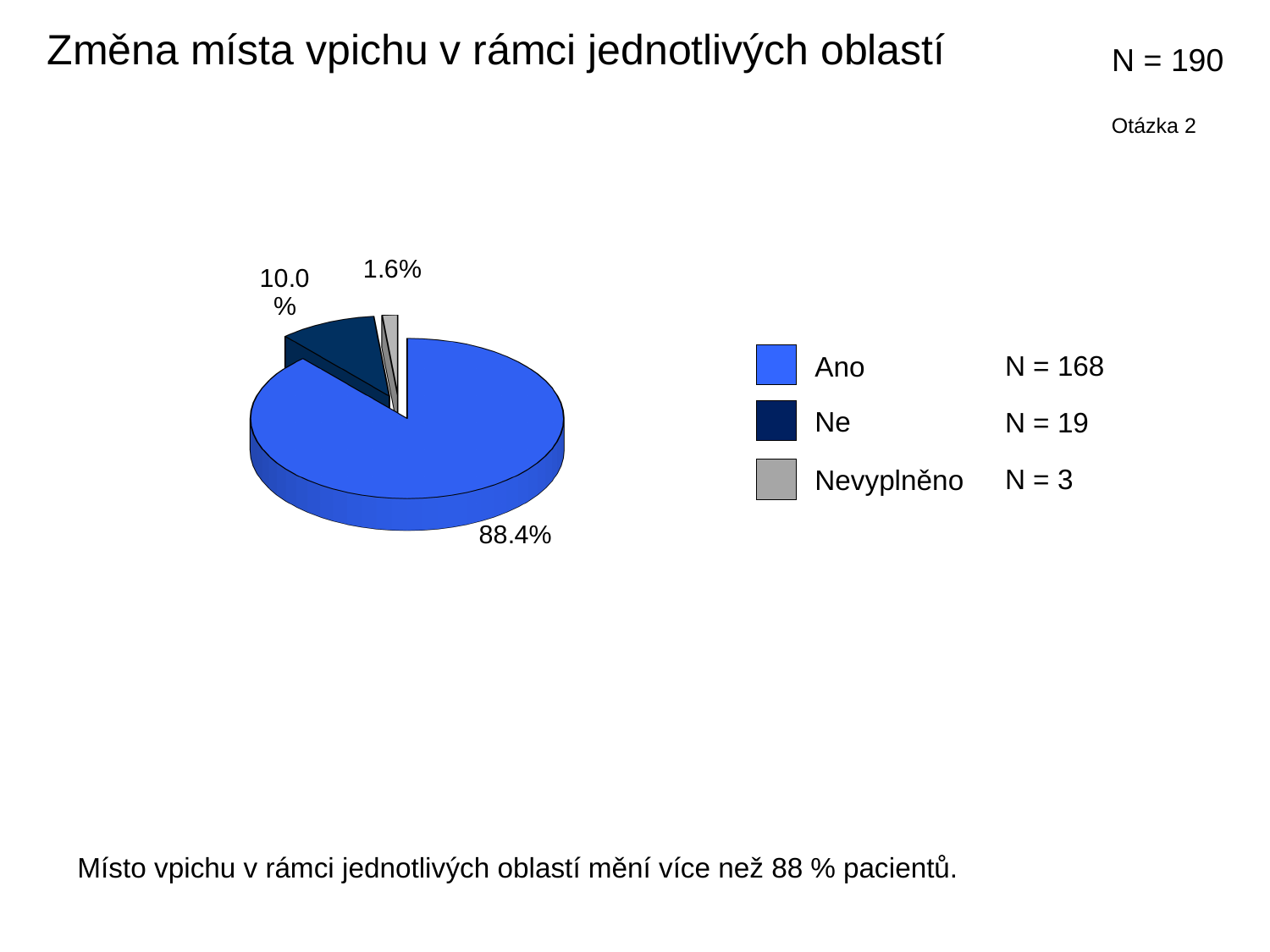
What kind of chart is shown on the slide? pie chart Which category has the smallest slice of the pie? Nevyplněno What is the title of the chart on the slide? Změna místa vpichu v rámci jednotlivých oblastí What percentage share does the "Nevyplněno" slice have? 1.6% What percentage share does the "Ne" slice have? 10.0% Which slice is larger, "Ne" or "Nevyplněno"? Ne What percentage share does the "Ano" slice have? 88.4% What is the difference in percentage points between the "Ano" and "Ne" slices? 78.4 What is the N value shown for "Ne" in the legend? N = 19 What is the N value shown for "Ano" in the legend? N = 168 How many categories does the pie chart show? 3 Which category has the largest slice of the pie? Ano